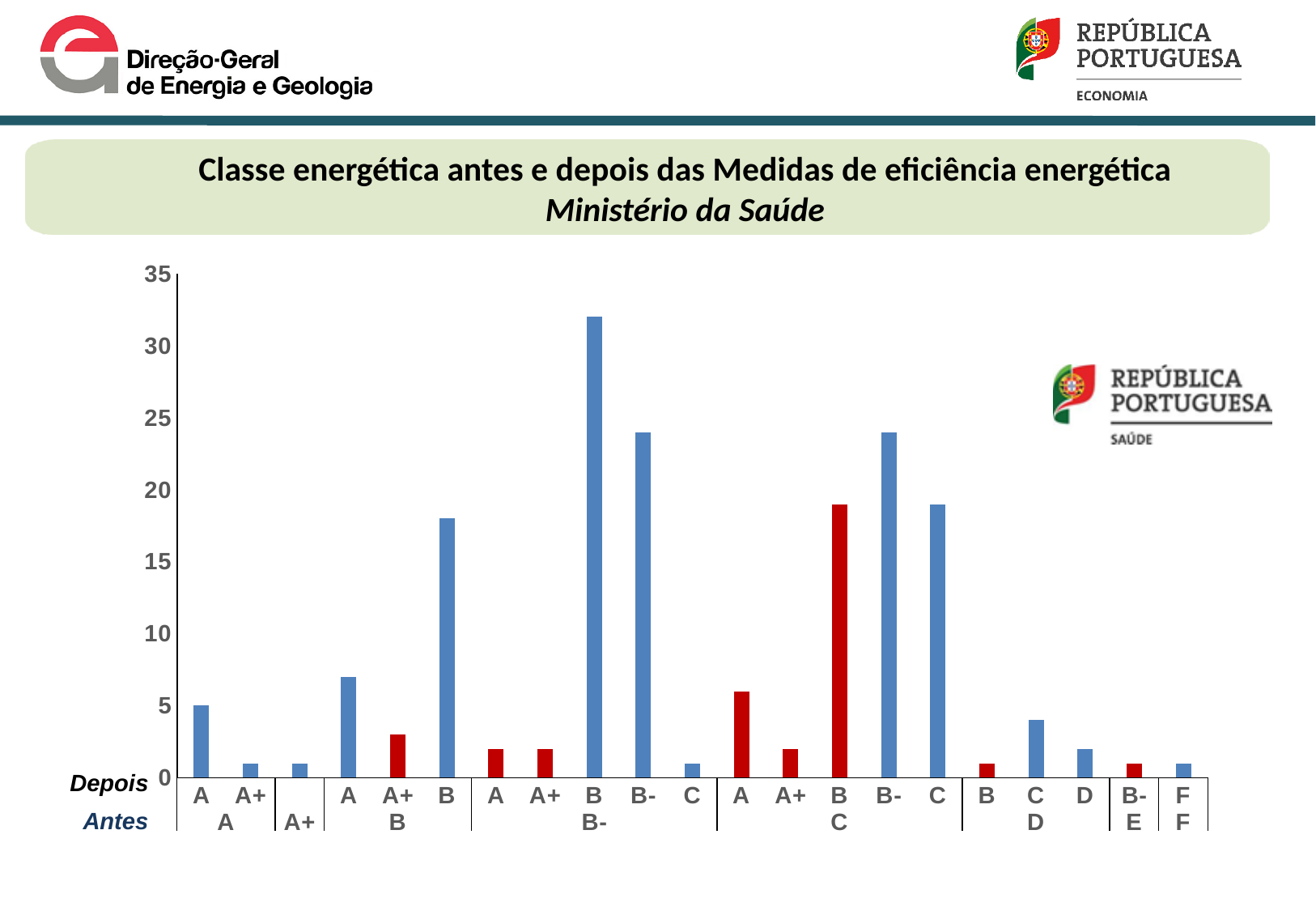
Is the value for the B- (Depois) bar in the B- (Antes) group greater or less than 20? greater What is the value for the A (Depois) bar in the A (Antes) group? 5 Is the value for the B (Depois) bar in the B (Antes) group greater or less than 15? greater Which is larger: the B- (Depois) bar in the B- (Antes) group or the B (Depois) bar in the C (Antes) group? B- (Depois) in the B- (Antes) group Is the value for the B (Depois) bar in the B- (Antes) group greater or less than 30? greater Which bar is the highest in the chart? B (Depois) in the B- (Antes) group What kind of chart is shown on the slide? bar chart What is the title of the chart on the slide? Classe energética antes e depois das Medidas de eficiência energética – Ministério da Saúde How many 'Antes' groups are shown along the x axis? 8 Which is larger: the B (Depois) bar in the B (Antes) group or the B- (Depois) bar in the C (Antes) group? B- (Depois) in the C (Antes) group